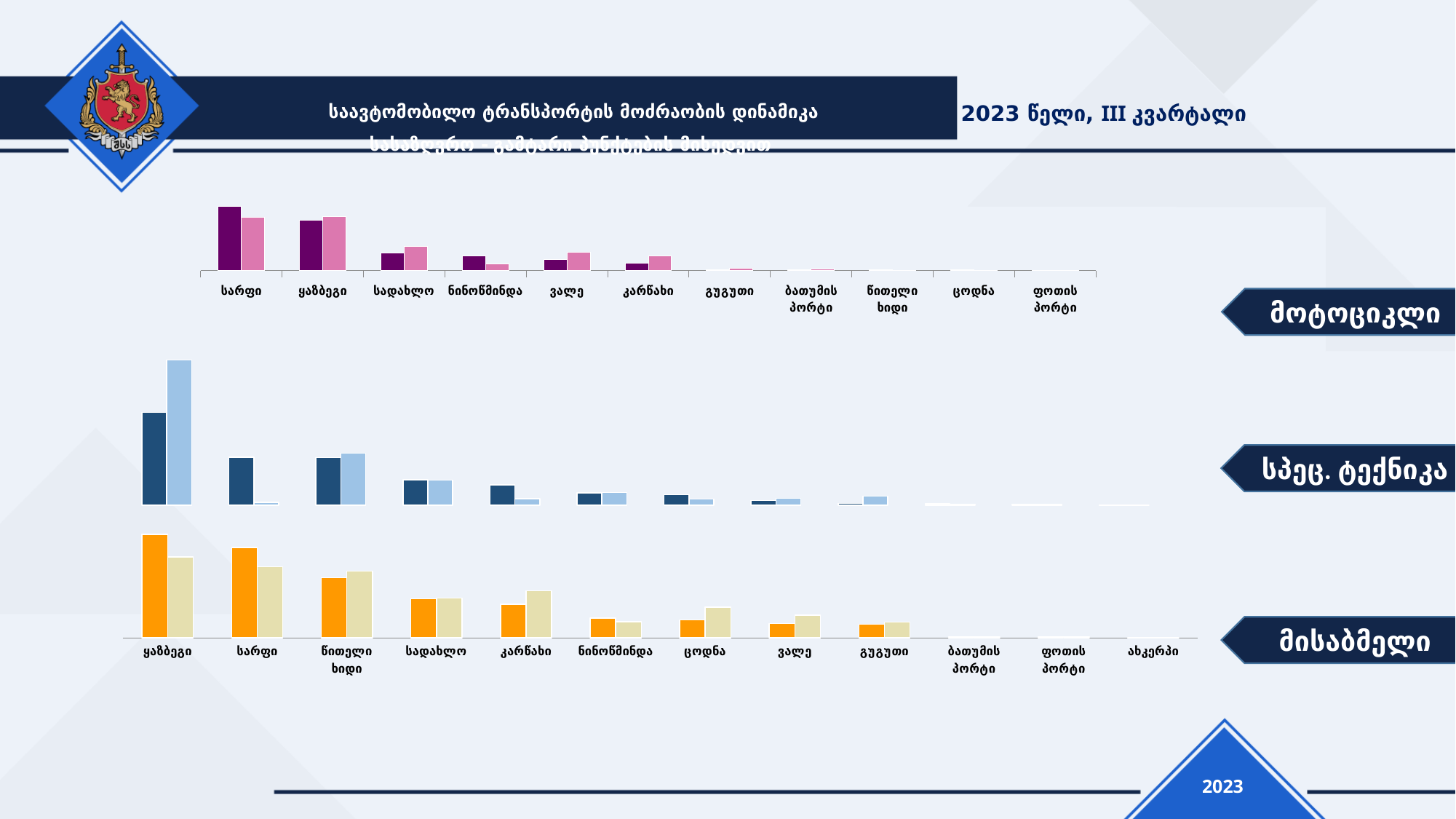
In the bottom chart (მისაბმელი), which category has the tallest orange bar? ყაზბეგი How many categories are shown on the x axis of the bottom chart (მისაბმელი)? 12 How many categories are shown on the x axis of the top chart (მოტოციკლი)? 11 In the bottom chart (მისაბმელი), for კარწახი, is the orange bar or the beige bar taller? beige What label appears to the right of the middle chart? სპეც. ტექნიკა In the top chart (მოტოციკლი), is the dark purple bar for სადახლო or for ნინოწმინდა taller? სადახლო In the top chart (მოტოციკლი), is the dark purple bar for სარფი or for ყაზბეგი taller? სარფი What kind of chart is the top chart labelled მოტოციკლი? bar chart In the bottom chart (მისაბმელი), do the orange bars generally rise or fall from left to right along the x axis? fall In the top chart (მოტოციკლი), which category has the tallest dark purple bar? სარფი